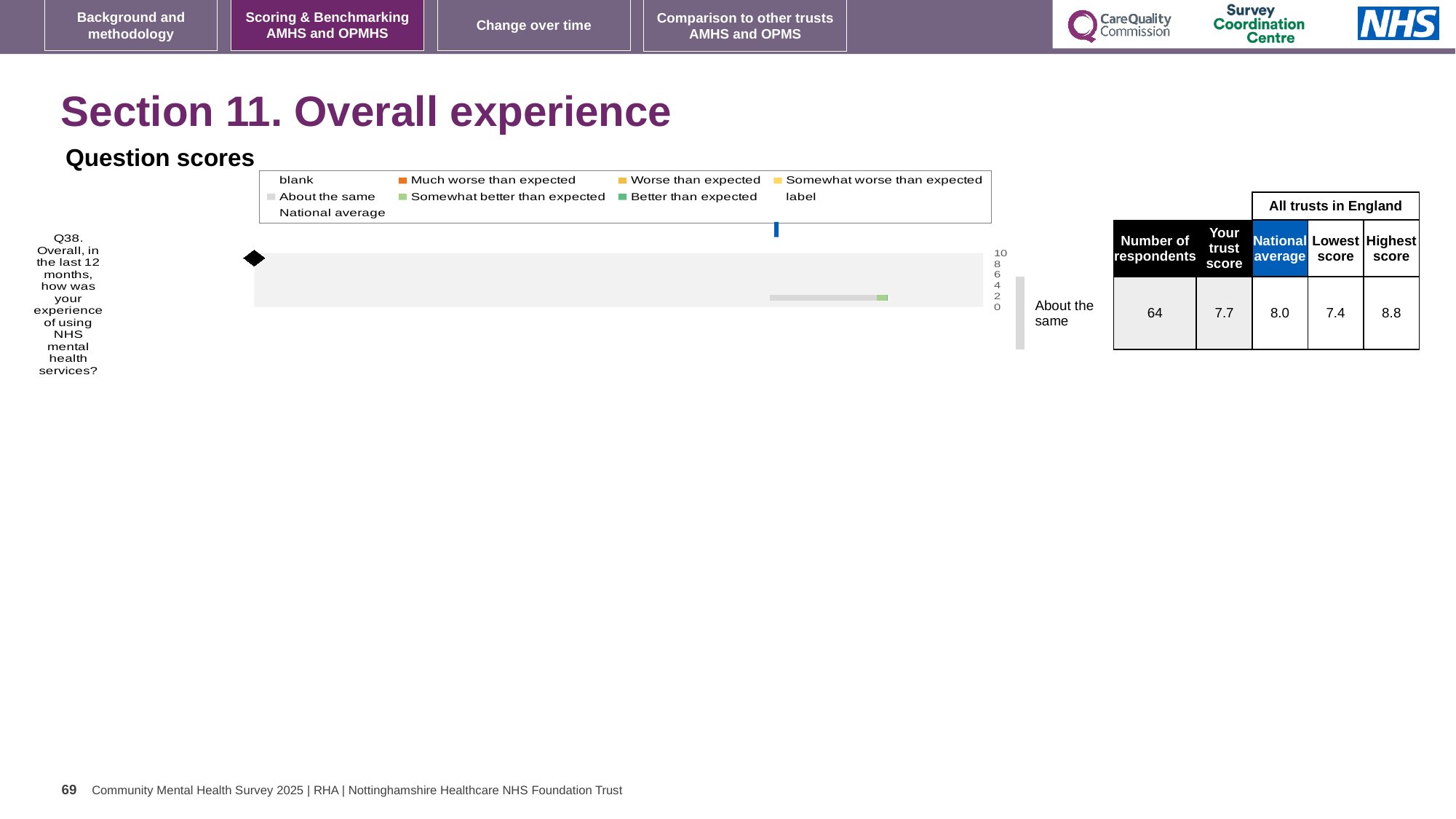
Which is larger for Q38: the trust's score or the national average? National average What is the national average score for Q38? 8.0 How is the trust's Q38 result categorised relative to expectations? About the same What is the highest value shown on the chart's score axis? 10 How many respondents answered Q38? 64 What is the difference between the highest and lowest trust scores for Q38? 1.4 What is the lowest score among all trusts in England for Q38? 7.4 What is the highest score among all trusts in England for Q38? 8.8 What is the difference between the national average and the trust's score for Q38? 0.3 How many questions are plotted in the Question scores chart? 1 What kind of chart is shown under 'Question scores'? bar chart What is the trust's score for Q38 (overall experience of using NHS mental health services)? 7.7